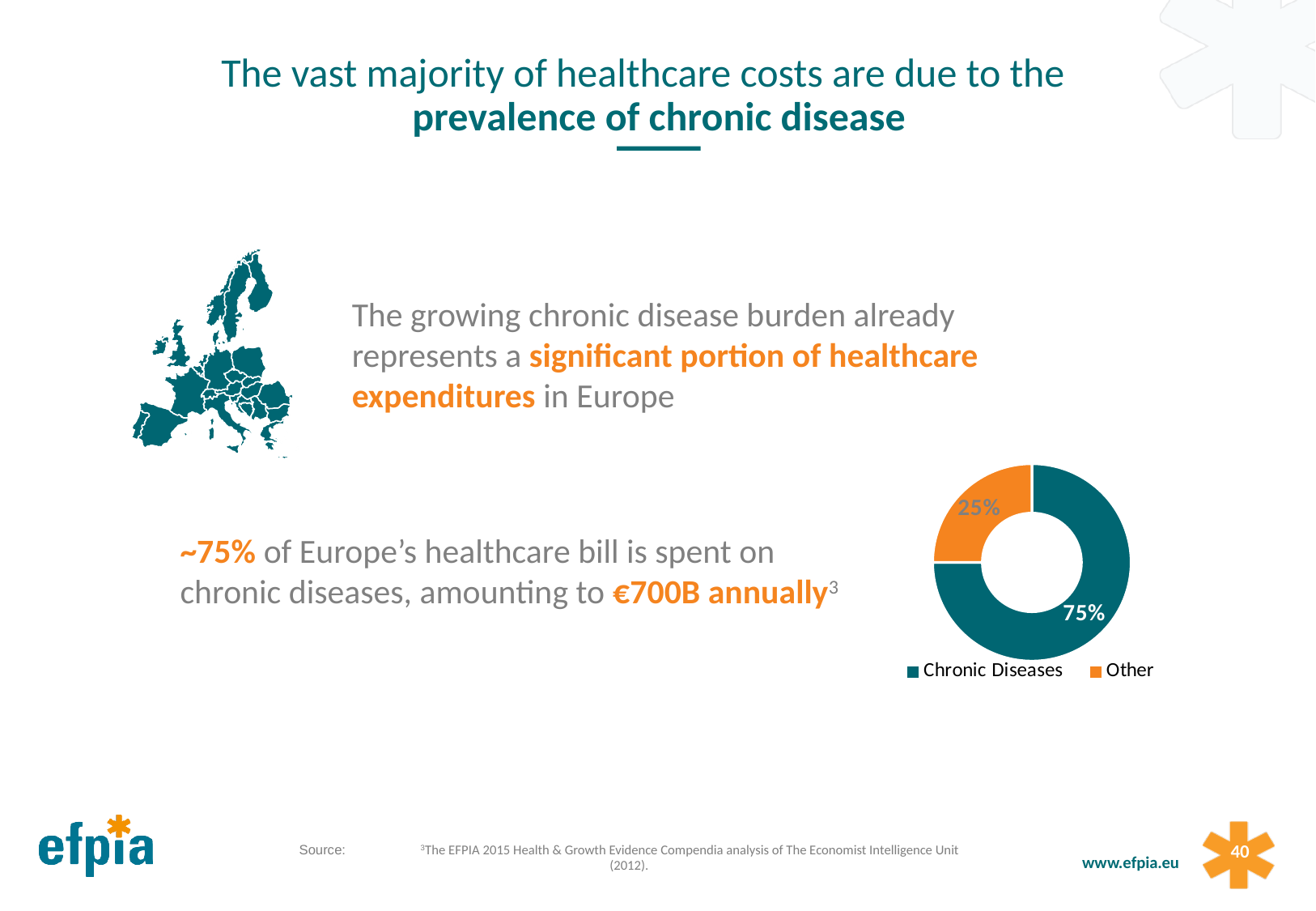
What kind of chart is shown on the slide? Donut (pie) chart How many entries does the chart legend list? 2 Which category has the largest share in the donut chart? Chronic Diseases What is the difference in percentage points between the Chronic Diseases share and the Other share? 50 What colour represents Other in the chart? Orange Which category has the smallest share in the donut chart? Other What colour represents Chronic Diseases in the chart? Teal What share of the donut chart is labelled for Chronic Diseases? 75% What share of the donut chart is labelled for Other? 25% What is the total of the two shares shown in the donut chart? 100% How many categories does the donut chart show? 2 Which is larger in the donut chart, Chronic Diseases or Other? Chronic Diseases